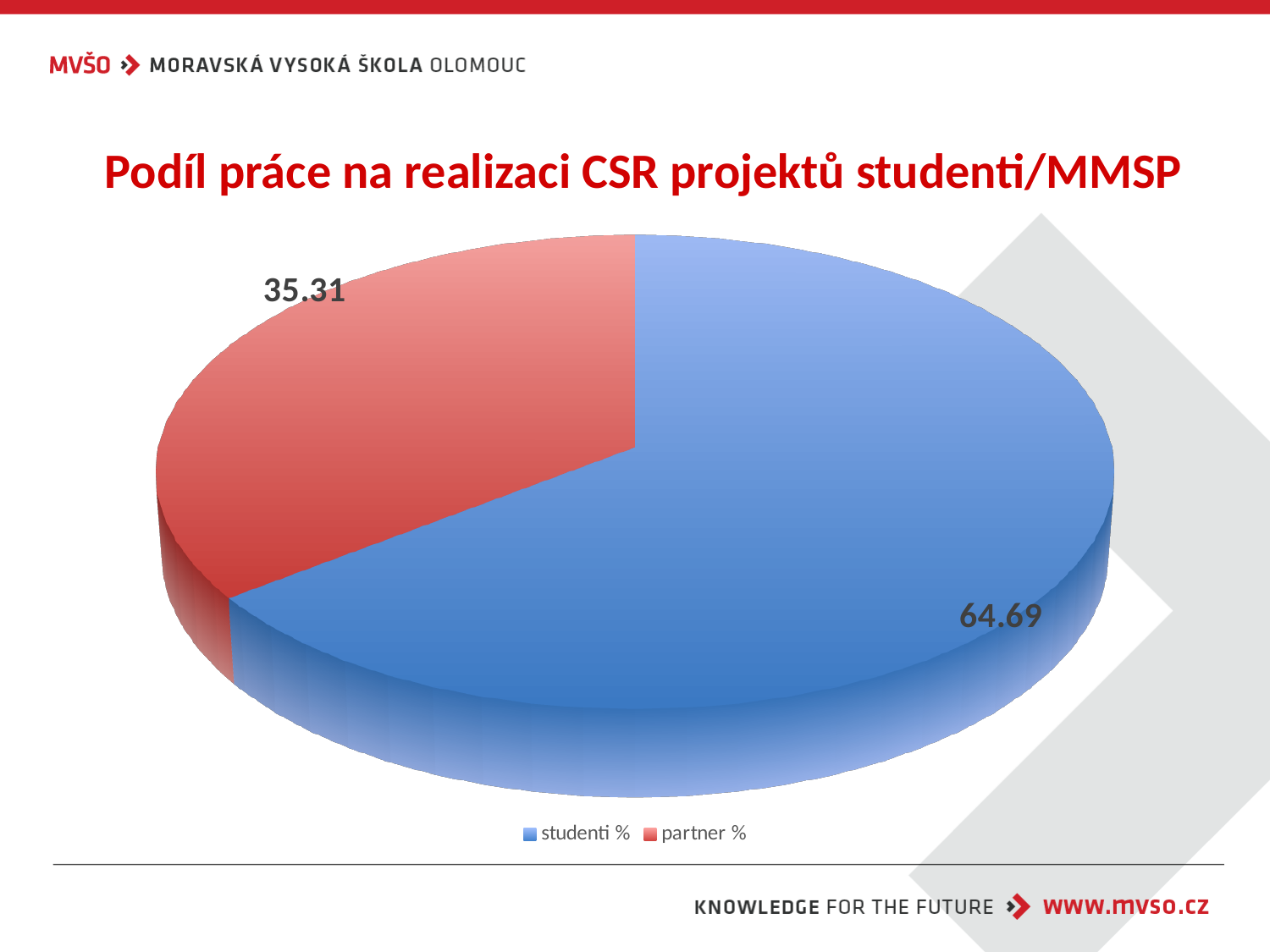
What colour is the partner % slice? red Which slice is the smallest? partner % Which slice is the largest? studenti % What is the difference between the studenti % and partner % values? 29.38 How many slices does the pie chart have? 2 What is the value for studenti %? 64.69 Which is larger, studenti % or partner %? studenti % What is the value for partner %? 35.31 How many entries does the legend list? 2 What kind of chart is shown on the slide? pie chart What is the title of the chart? Podíl práce na realizaci CSR projektů studenti/MMSP